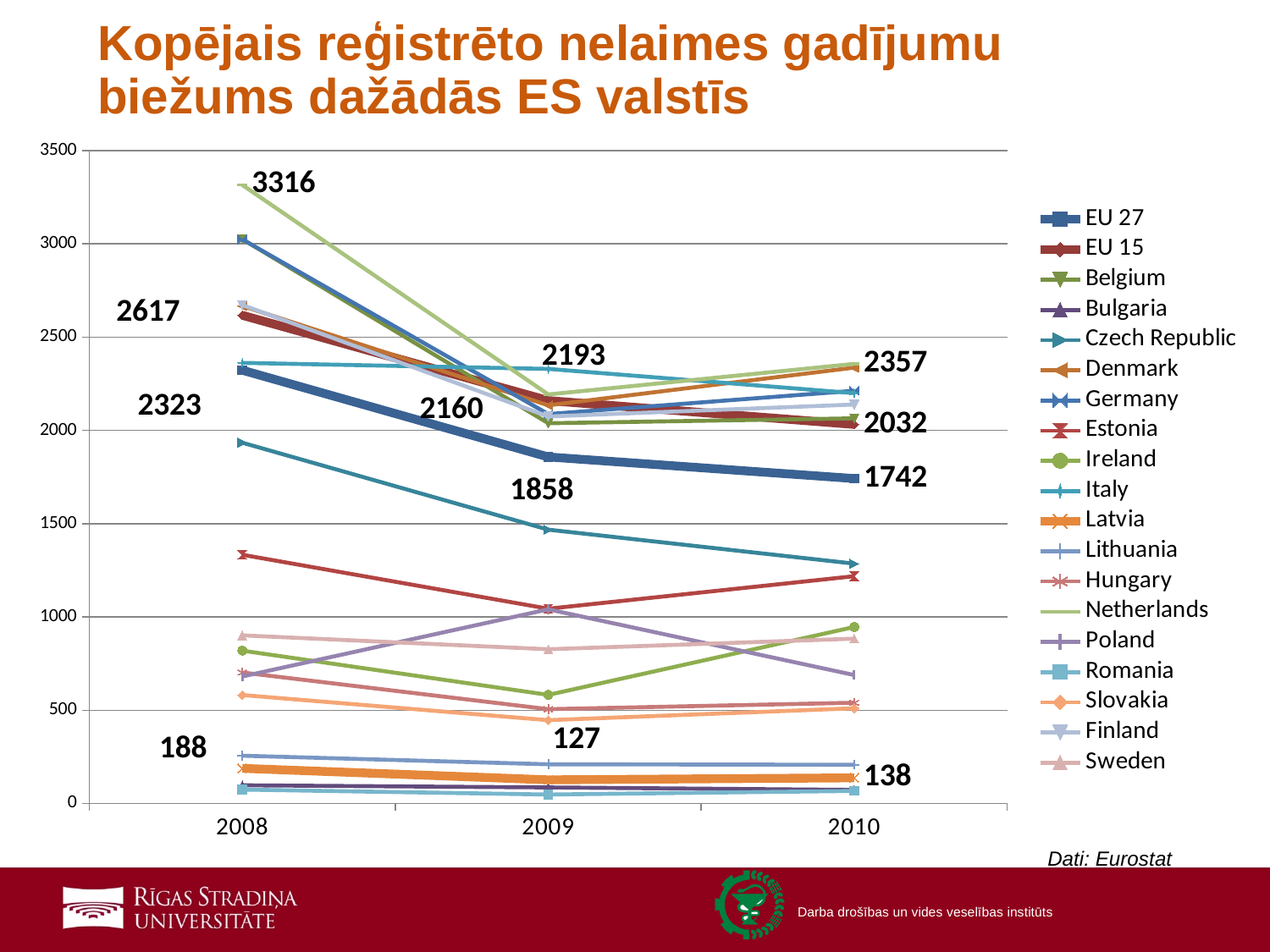
Does the EU 27 line rise or fall from 2008 to 2010? fall How many years are shown on the x axis? 3 What kind of chart is shown on the slide? line chart What is the value for Latvia in 2009? 127 What is the value for EU 27 in 2008? 2323 By how much did the EU 27 value fall from 2008 to 2010? 581 Is the value for Romania in 2010 greater or less than 500? less Which country has the highest value in 2008? Netherlands What is the value for EU 15 in 2008? 2617 What is the value for EU 27 in 2010? 1742 What is the difference between the Latvia values for 2008 and 2010? 50 How many series does the legend list? 19